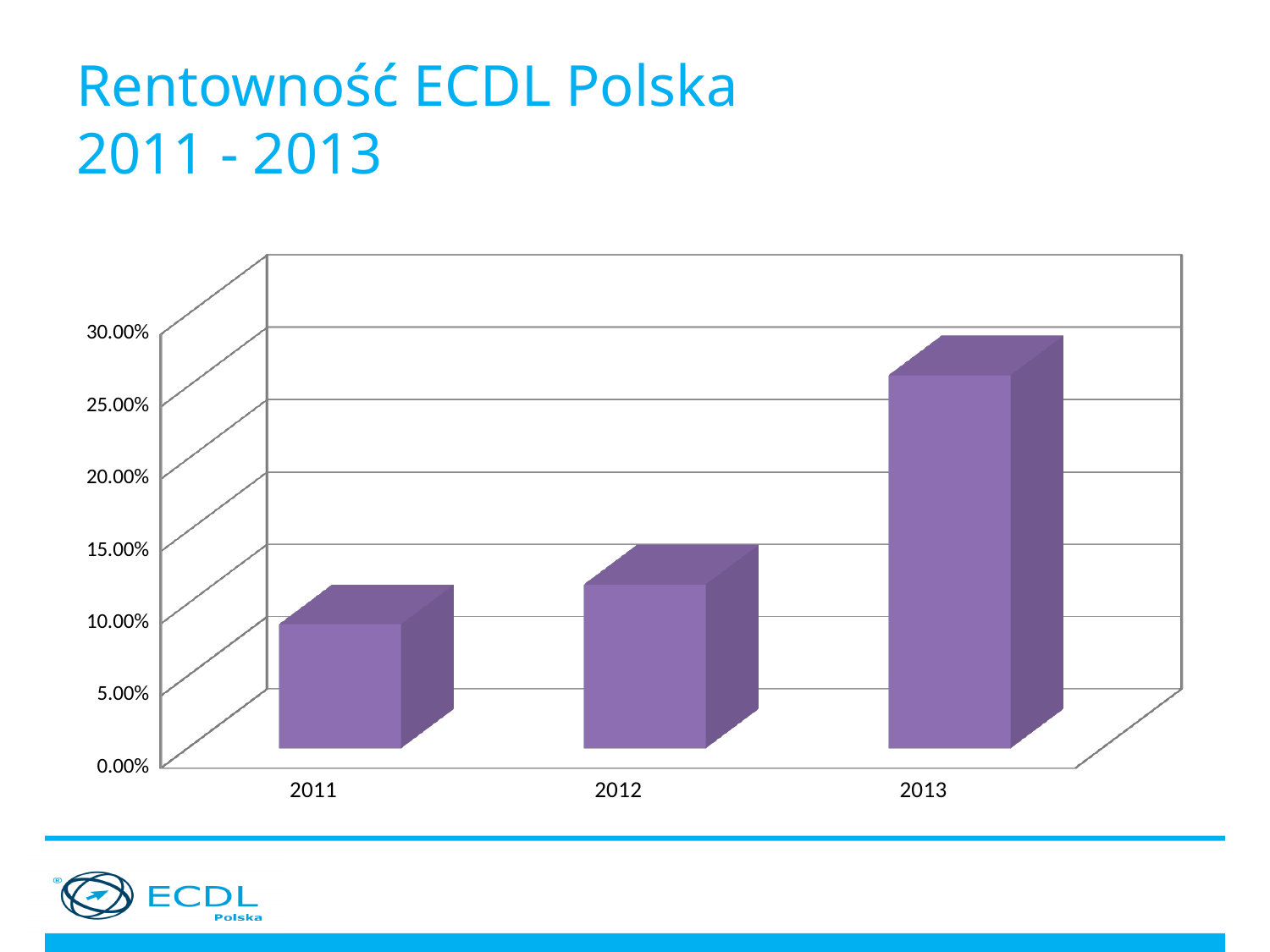
Is the value for 2011 greater or less than 5.00%? greater What is the title of the slide containing the chart? Rentowność ECDL Polska 2011 - 2013 Which year has the lowest value in the chart? 2011 Which is larger, the value for 2013 or the value for 2012? 2013 Is the value for 2011 greater or less than 15.00%? less What kind of chart is shown on the slide? bar chart Which year has the highest value in the chart? 2013 Do the values rise or fall from 2011 to 2013? rise Is the value for 2012 greater or less than 20.00%? less How many years are shown on the x axis of the chart? 3 Which is larger, the value for 2012 or the value for 2011? 2012